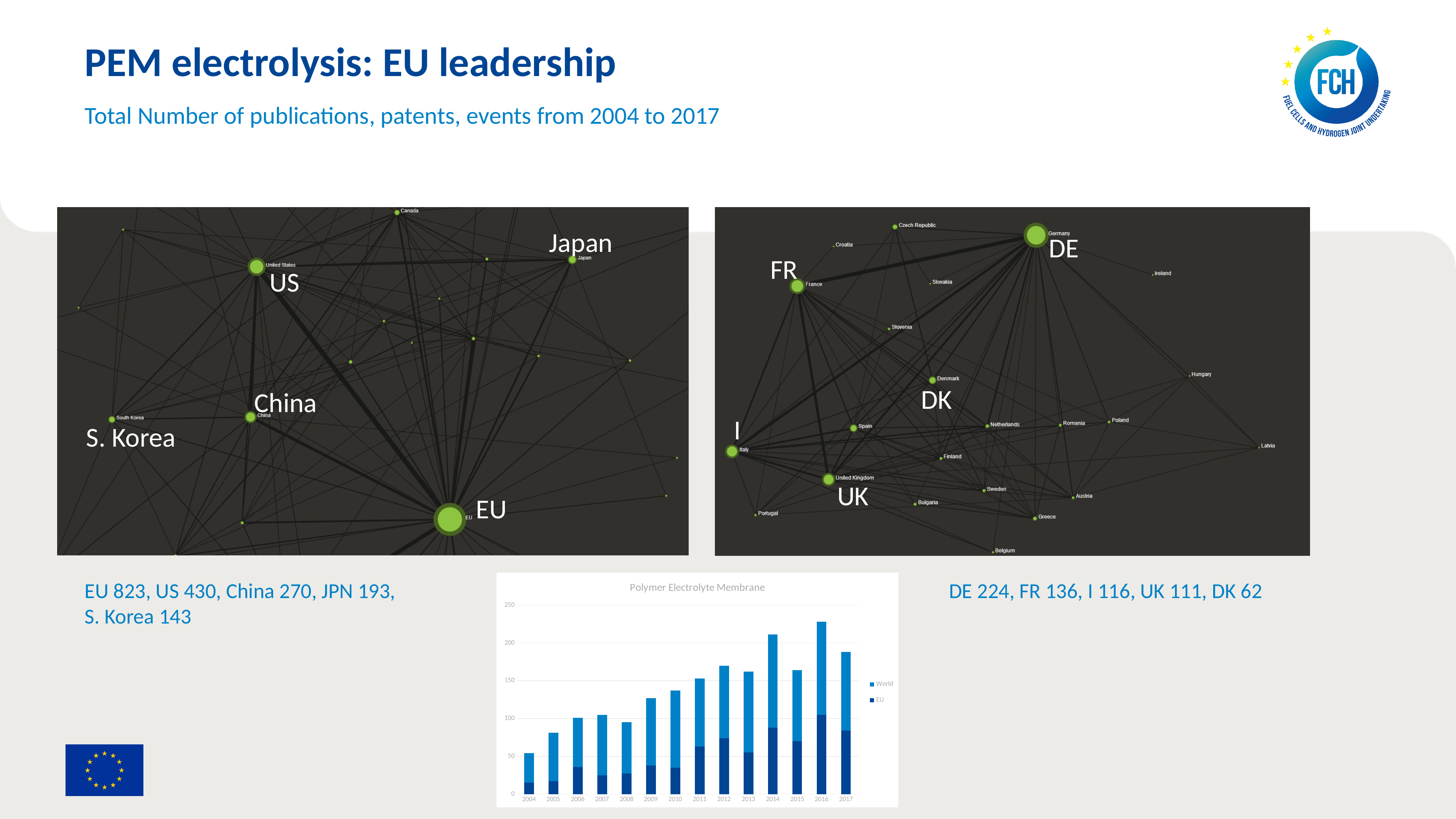
What kind of chart is the 'Polymer Electrolyte Membrane' chart at the bottom of the slide? Stacked bar chart In the 'Polymer Electrolyte Membrane' chart, is the total bar for 2004 greater or less than 100? less In the 'Polymer Electrolyte Membrane' chart, which year has the tallest stacked bar? 2016 How many years are shown on the x axis of the 'Polymer Electrolyte Membrane' chart? 14 In the 'Polymer Electrolyte Membrane' chart, is the total bar for 2017 greater or less than 200? less What are the two legend entries in the 'Polymer Electrolyte Membrane' chart? World and EU In the 'Polymer Electrolyte Membrane' chart, which year has the shortest stacked bar? 2004 In the 'Polymer Electrolyte Membrane' chart, do the total bars generally rise or fall from 2004 to 2016? rise In the 'Polymer Electrolyte Membrane' chart, is the total bar for 2016 greater or less than 200? greater According to the values printed under the left network graph, what is the value for the US? 430 How many series does the legend of the 'Polymer Electrolyte Membrane' chart list? 2 In the 'Polymer Electrolyte Membrane' chart, which year has the larger total bar, 2014 or 2015? 2014